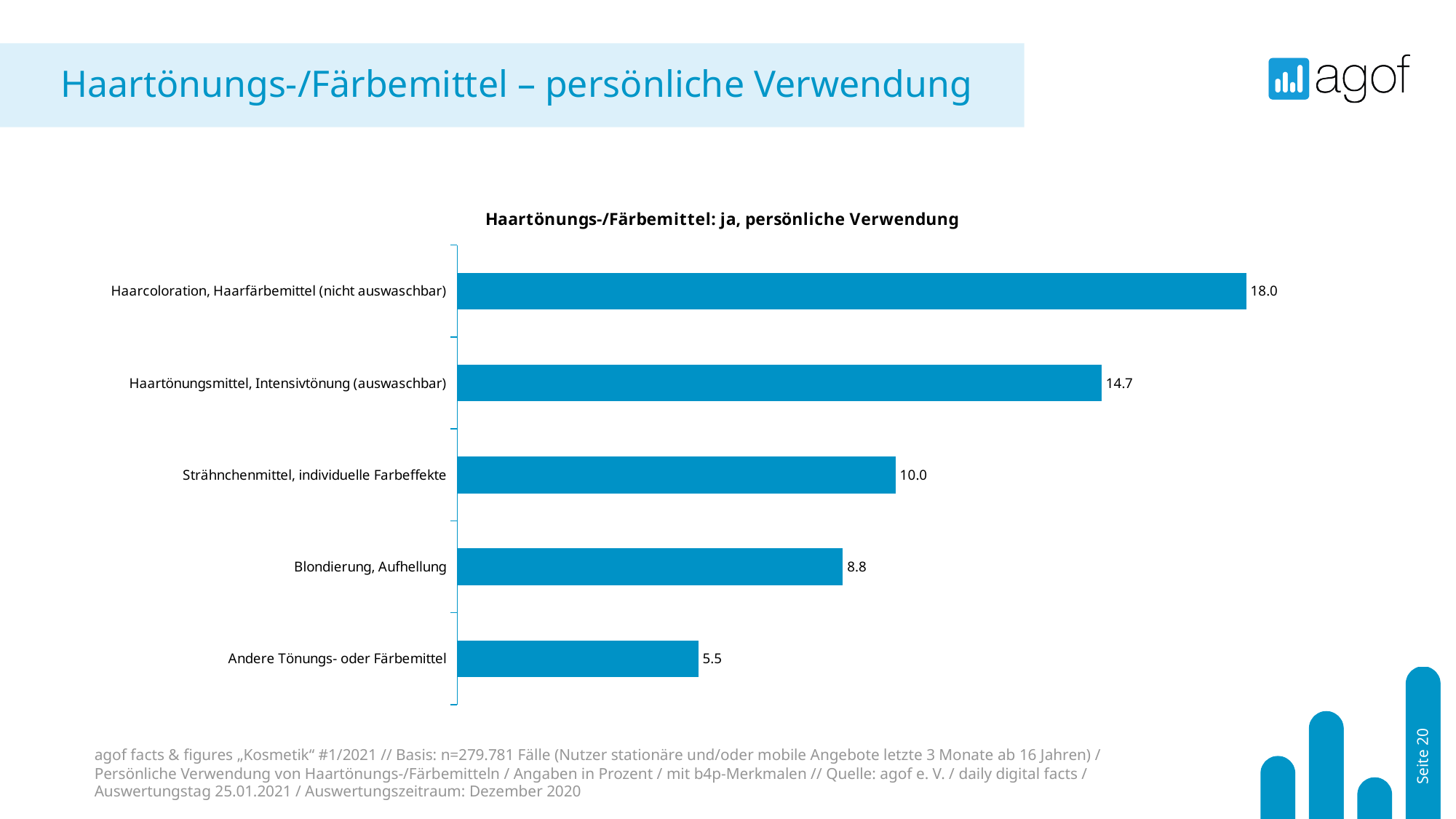
What is the value for Haarcoloration, Haarfärbemittel (nicht auswaschbar)? 18.0 What is the value for Haartönungsmittel, Intensivtönung (auswaschbar)? 14.7 What is the title of the chart? Haartönungs-/Färbemittel: ja, persönliche Verwendung What is the value for Strähnchenmittel, individuelle Farbeffekte? 10.0 How many categories are shown in the chart? 5 What is the difference between the values for Haarcoloration, Haarfärbemittel (nicht auswaschbar) and Haartönungsmittel, Intensivtönung (auswaschbar)? 3.3 Which category has the highest value? Haarcoloration, Haarfärbemittel (nicht auswaschbar) Which category has the lowest value? Andere Tönungs- oder Färbemittel What kind of chart is shown on the slide? Bar chart Which is larger: the value for Strähnchenmittel, individuelle Farbeffekte or Blondierung, Aufhellung? Strähnchenmittel, individuelle Farbeffekte What is the value for Blondierung, Aufhellung? 8.8 What is the value for Andere Tönungs- oder Färbemittel? 5.5